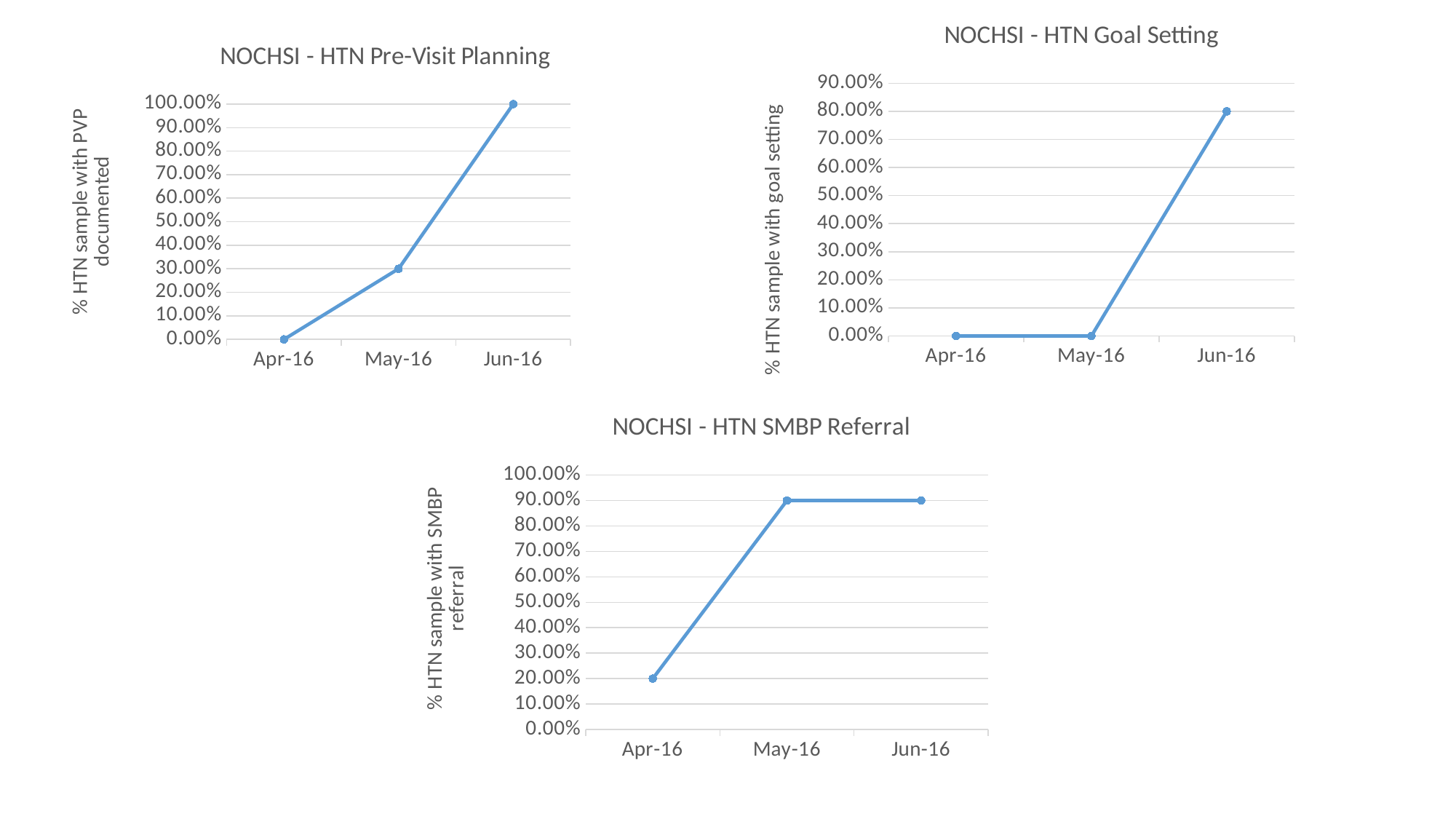
How many data points are plotted in the NOCHSI - HTN SMBP Referral chart? 3 In the NOCHSI - HTN Goal Setting chart, what is the value for Jun-16? 80.00% In the NOCHSI - HTN Pre-Visit Planning chart, what is the value for Jun-16? 100.00% In the NOCHSI - HTN Pre-Visit Planning chart, what is the difference between the Jun-16 and May-16 values? 70.00% In the NOCHSI - HTN SMBP Referral chart, what is the value for Apr-16? 20.00% In the NOCHSI - HTN SMBP Referral chart, what is the difference between the May-16 and Apr-16 values? 70.00% In the NOCHSI - HTN Goal Setting chart, which month has the highest value? Jun-16 In the NOCHSI - HTN Pre-Visit Planning chart, which month has the lowest value? Apr-16 What kind of chart is the NOCHSI - HTN Goal Setting chart? Line chart In the NOCHSI - HTN SMBP Referral chart, what is the value for May-16? 90.00% In the NOCHSI - HTN Pre-Visit Planning chart, what is the value for May-16? 30.00% In the NOCHSI - HTN Goal Setting chart, is the value for Jun-16 greater or less than 50.00%? greater